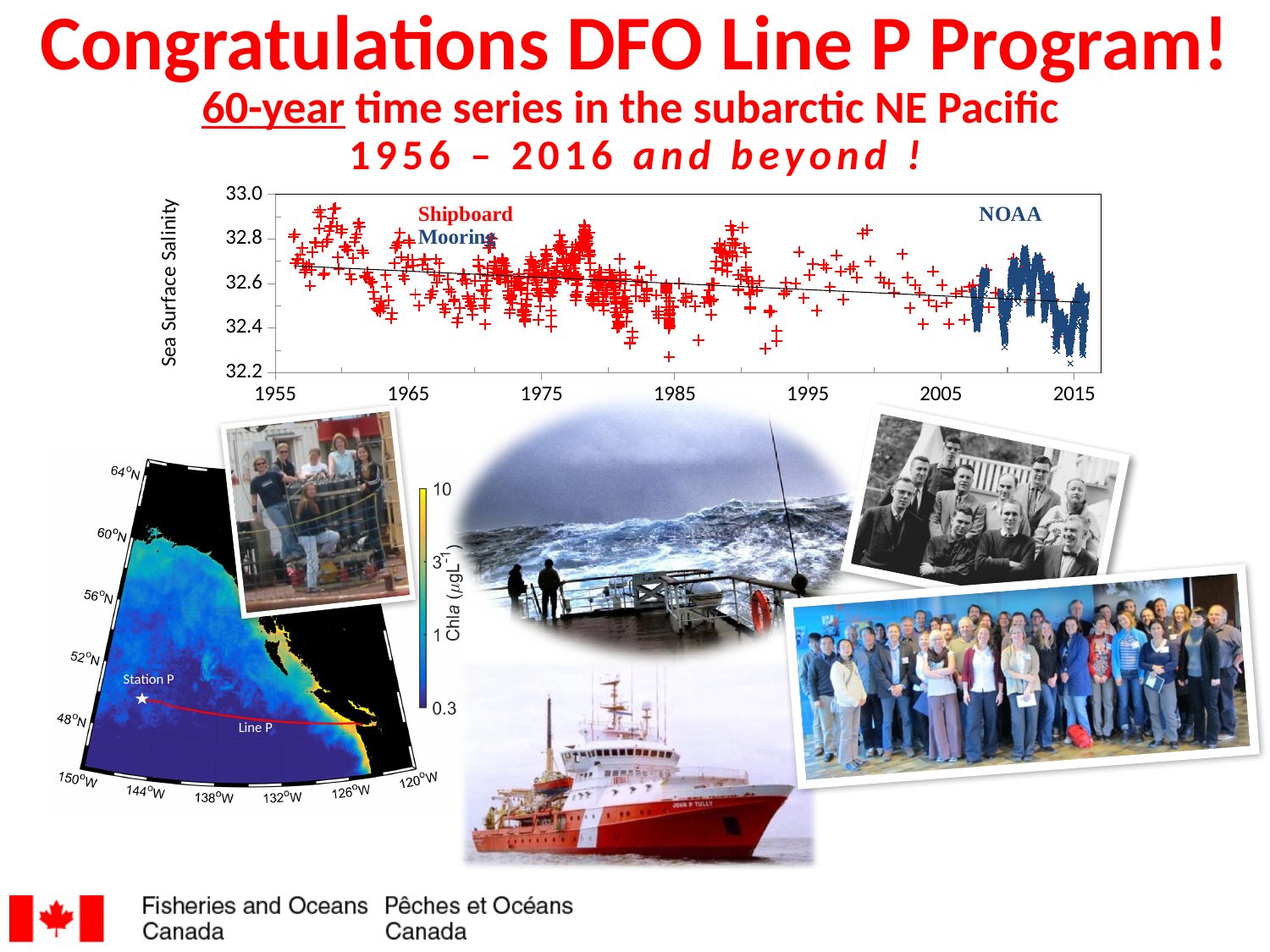
What colour are the Shipboard data points in the Sea Surface Salinity chart? red What kind of chart is the Sea Surface Salinity plot at the top of the slide? scatter plot What is the last year shown on the x-axis of the Sea Surface Salinity chart? 2015 In the Sea Surface Salinity chart, is the trend line value at 1955 greater or less than 32.6? greater What is the lowest value shown on the y-axis of the Sea Surface Salinity chart? 32.2 In the Sea Surface Salinity chart, which series covers the later years, Shipboard or NOAA Mooring? NOAA Mooring How many data series are labelled in the Sea Surface Salinity chart? 2 In the Sea Surface Salinity chart, does the trend line rise or fall from 1955 to 2015? fall What is the highest value shown on the y-axis of the Sea Surface Salinity chart? 33.0 What is the label of the y-axis in the Sea Surface Salinity chart? Sea Surface Salinity What is the first year shown on the x-axis of the Sea Surface Salinity chart? 1955 In the Sea Surface Salinity chart, is the trend line value at 2015 greater or less than 32.6? less